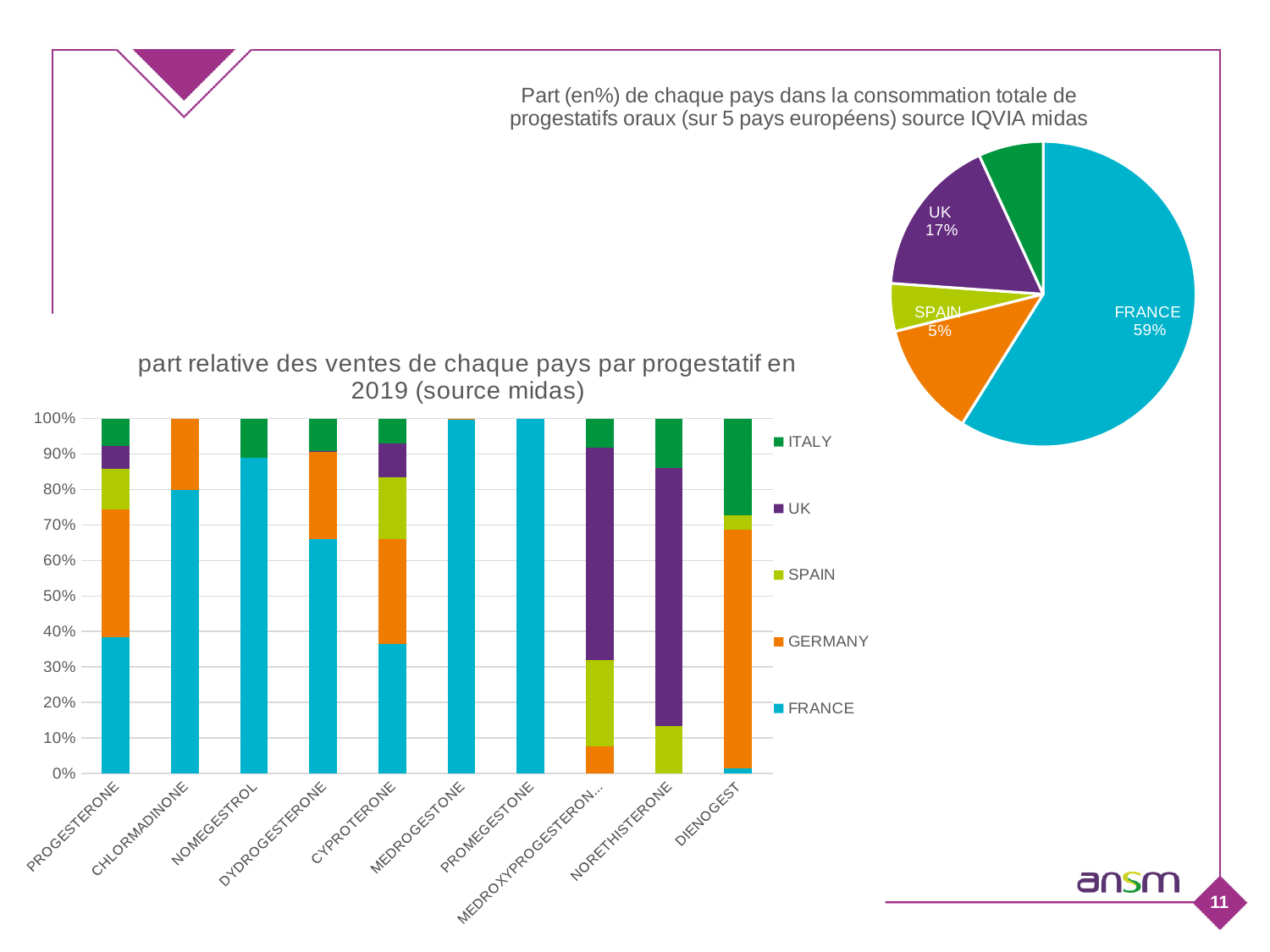
On the bar chart 'part relative des ventes de chaque pays par progestatif en 2019', how many series does the legend list? 5 On the pie chart (top right), what share does SPAIN have? 5% On the bar chart 'part relative des ventes de chaque pays par progestatif en 2019', which colour represents FRANCE in the legend? light blue (cyan) On the pie chart (top right), what share does UK have? 17% On the bar chart 'part relative des ventes de chaque pays par progestatif en 2019', is the FRANCE share for CHLORMADINONE greater or less than 70%? greater On the pie chart (top right), what is the difference between the FRANCE share and the UK share? 42% What kind of chart is the chart titled 'part relative des ventes de chaque pays par progestatif en 2019 (source midas)'? stacked bar chart On the pie chart (top right), which is larger, the UK share or the SPAIN share? UK On the bar chart 'part relative des ventes de chaque pays par progestatif en 2019', how many progestatif categories are shown on the x axis? 10 On the pie chart (top right), which country has the largest slice? FRANCE On the pie chart (top right), what share does FRANCE have? 59%